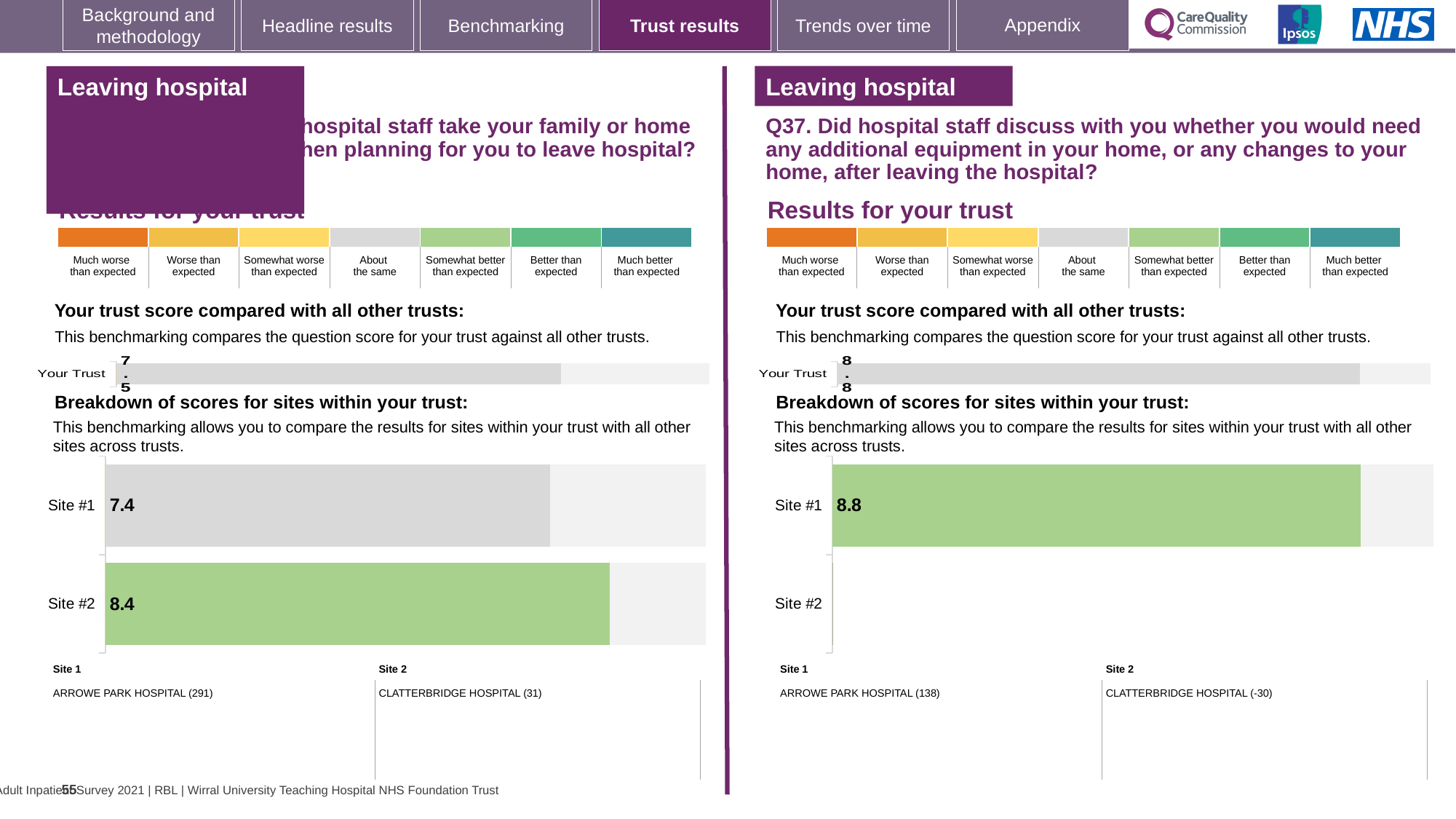
On the left-hand site breakdown chart, which site has the higher score? Site #2 On the left-hand site breakdown chart, what is the difference between the Site #2 and Site #1 scores? 1.0 Is the Site #1 score on the right-hand (Q37) site breakdown chart larger or smaller than the Site #1 score on the left-hand site breakdown chart? Larger On the left-hand site breakdown chart, what is the score for Site #1? 7.4 On the left-hand site breakdown chart, how many sites are shown? 2 On the left-hand 'Your trust score compared with all other trusts' chart, what is the score for Your Trust? 7.5 On the right-hand (Q37) site breakdown chart, which site has no bar plotted? Site #2 What type of chart is used for the site breakdown on the left-hand side of the slide? Bar chart On the right-hand (Q37) 'Your trust score compared with all other trusts' chart, what is the score for Your Trust? 8.8 On the right-hand (Q37) site breakdown chart, what is the score for Site #1? 8.8 On the left-hand site breakdown chart, what is the score for Site #2? 8.4 On the left-hand site breakdown chart, is the Site #1 bar coloured grey or green? Grey